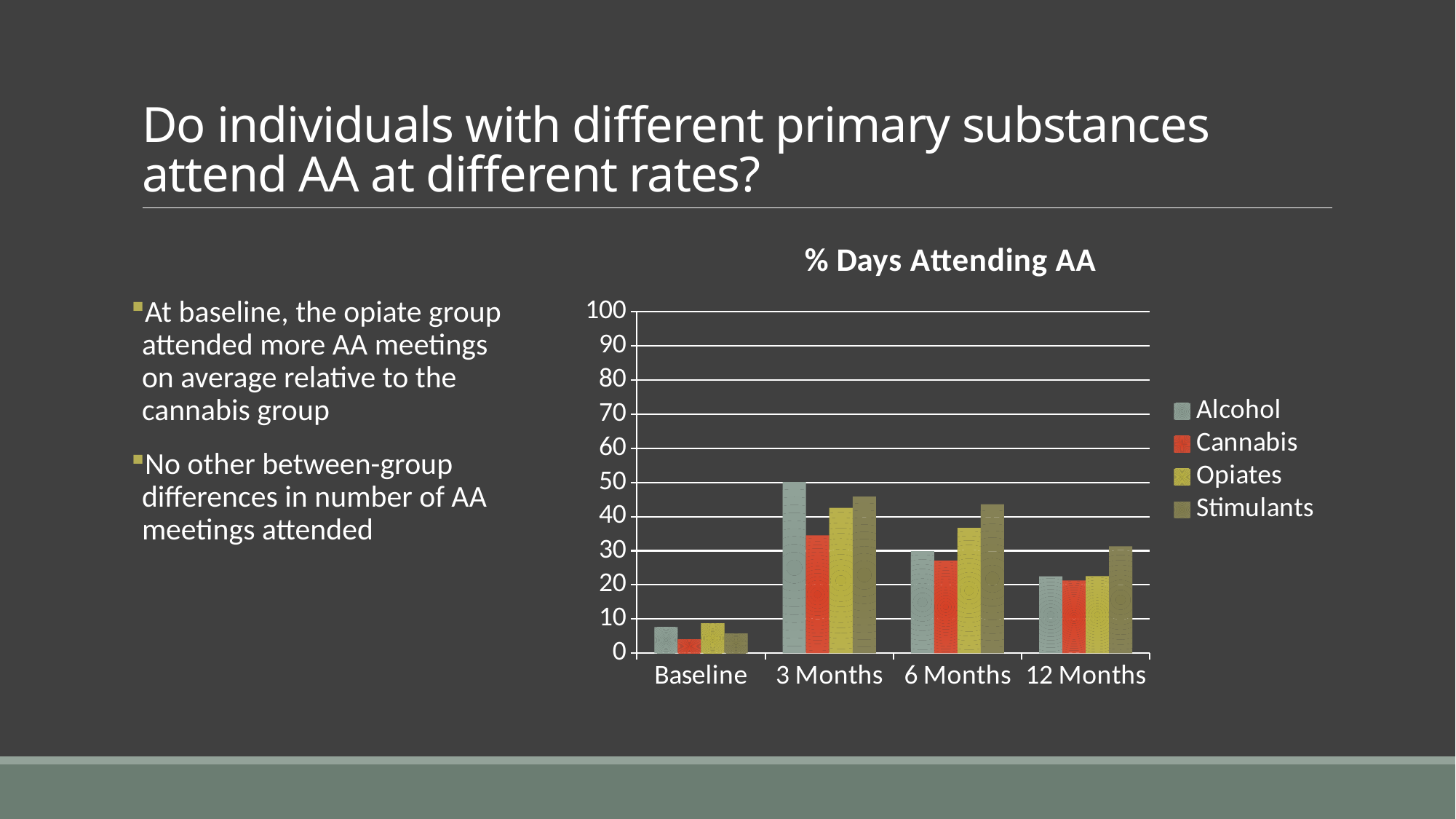
Is the value for Alcohol at 3 Months greater or less than 40? greater How many time-point categories are shown on the x axis? 4 Which group has the highest value at 12 Months? Stimulants Which group has the lowest value at 3 Months? Cannabis How many series does the legend list? 4 What kind of chart is shown on the slide? bar chart What is the title of the chart? % Days Attending AA Which group has the highest value at 6 Months? Stimulants At 6 Months, which is larger: the value for Opiates or the value for Cannabis? Opiates Is the value for Cannabis at Baseline greater or less than 10? less Does the value for Alcohol rise or fall from 3 Months to 12 Months? fall Which group has the highest value at 3 Months? Alcohol